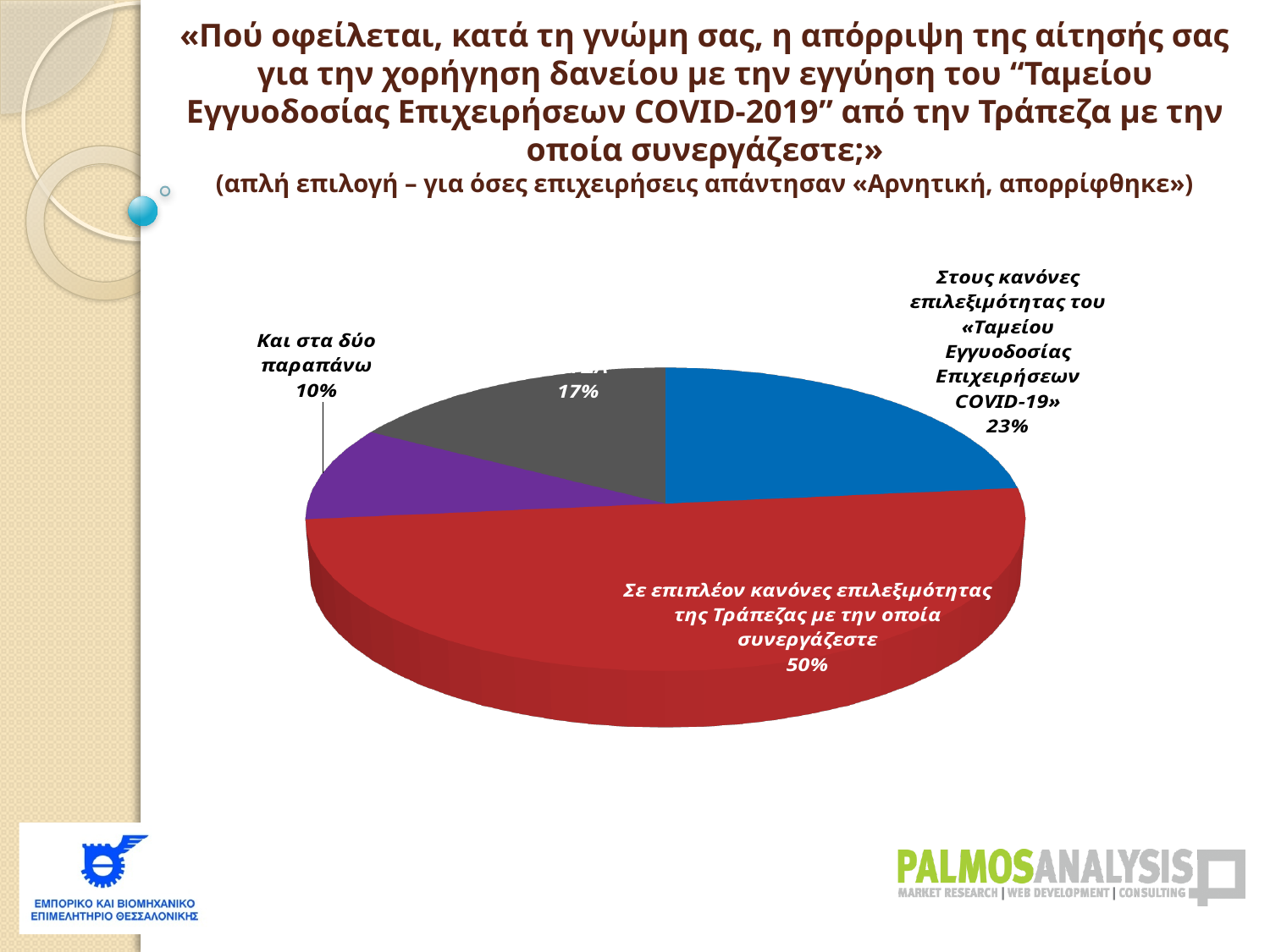
What colour is the slice for «Και στα δύο παραπάνω»? Purple How many slices does the pie chart have? 4 What type of chart is shown on the slide? Pie chart What colour is the slice representing the bank's additional eligibility rules (50%)? Red What percentage of respondents attributed the rejection to the eligibility rules of the «Ταμείου Εγγυοδοσίας Επιχειρήσεων COVID-19»? 23% Which response has the largest share of the pie? Σε επιπλέον κανόνες επιλεξιμότητας της Τράπεζας με την οποία συνεργάζεστε What percentage of respondents chose «Και στα δύο παραπάνω» (both of the above)? 10% What percentage of respondents attributed the rejection to additional eligibility rules of the bank they work with (Σε επιπλέον κανόνες επιλεξιμότητας της Τράπεζας με την οποία συνεργάζεστε)? 50% Which is larger: the share for the Fund's eligibility rules («Ταμείου Εγγυοδοσίας Επιχειρήσεων COVID-19») or the share for «Και στα δύο παραπάνω»? Στους κανόνες επιλεξιμότητας του «Ταμείου Εγγυοδοσίας Επιχειρήσεων COVID-19» What share of the pie is taken by the slice labelled 17%? 17% Which response has the smallest share of the pie? Και στα δύο παραπάνω What is the difference in percentage points between the share for the bank's additional eligibility rules and the share for the Fund's eligibility rules? 27